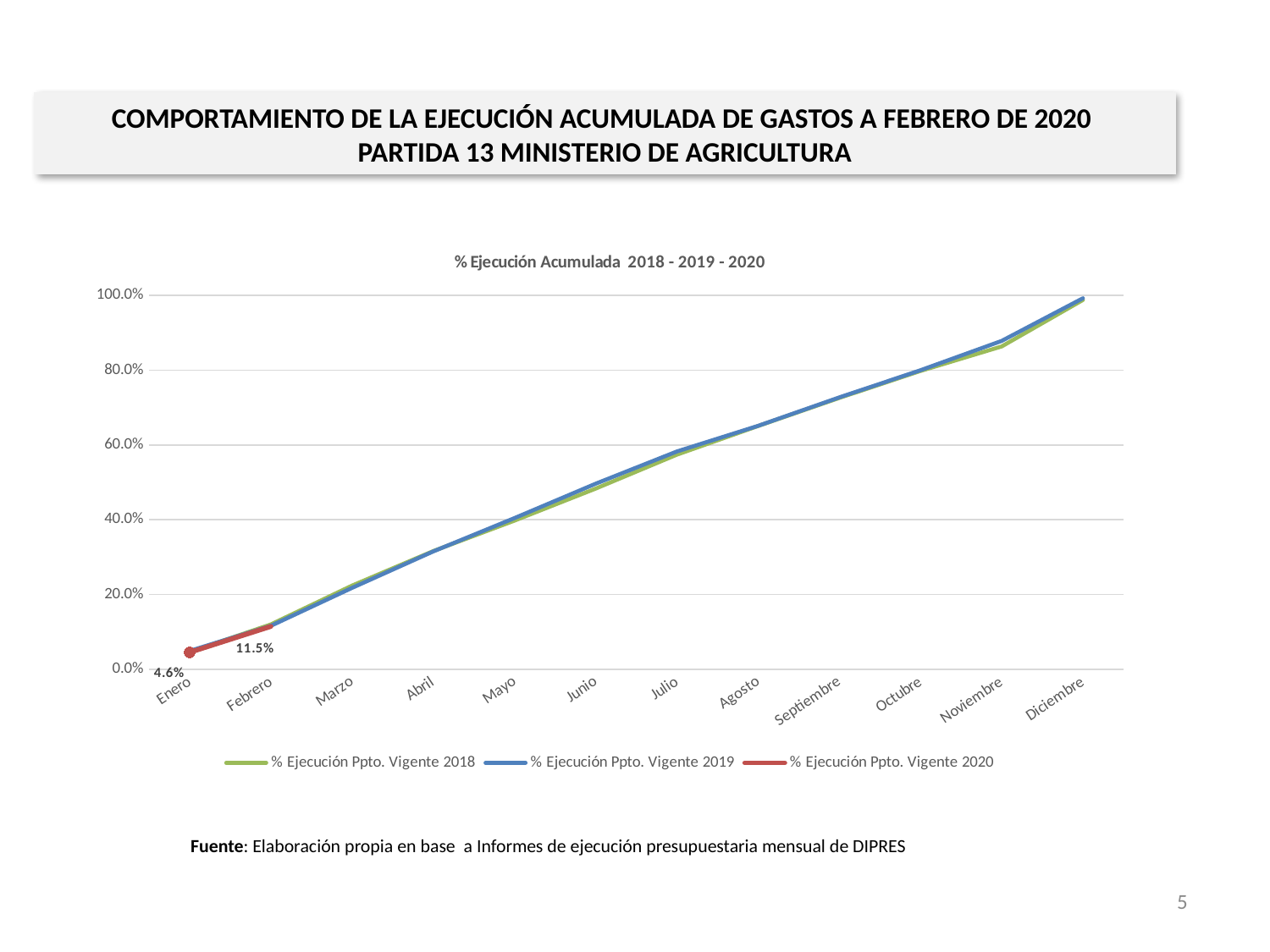
How many months are shown on the x axis of the chart? 12 What is the title of the chart? % Ejecución Acumulada 2018 - 2019 - 2020 By how many percentage points did the % Ejecución Ppto. Vigente 2020 series increase from Enero to Febrero? 6.9 percentage points What is the value for Febrero in the % Ejecución Ppto. Vigente 2020 series? 11.5% Is the value for Abril in the % Ejecución Ppto. Vigente 2019 series greater or less than 40%? less What kind of chart is shown on the slide? Line chart What is the value for Enero in the % Ejecución Ppto. Vigente 2020 series? 4.6% How many series does the legend list? 3 Is the value for Agosto in the % Ejecución Ppto. Vigente 2018 series greater or less than 60%? greater Is the value for Diciembre in the % Ejecución Ppto. Vigente 2019 series greater or less than 80%? greater Do the values of the % Ejecución Ppto. Vigente 2019 series rise or fall from Enero to Diciembre? Rise Which month has the higher value in the 2020 series, Enero or Febrero? Febrero